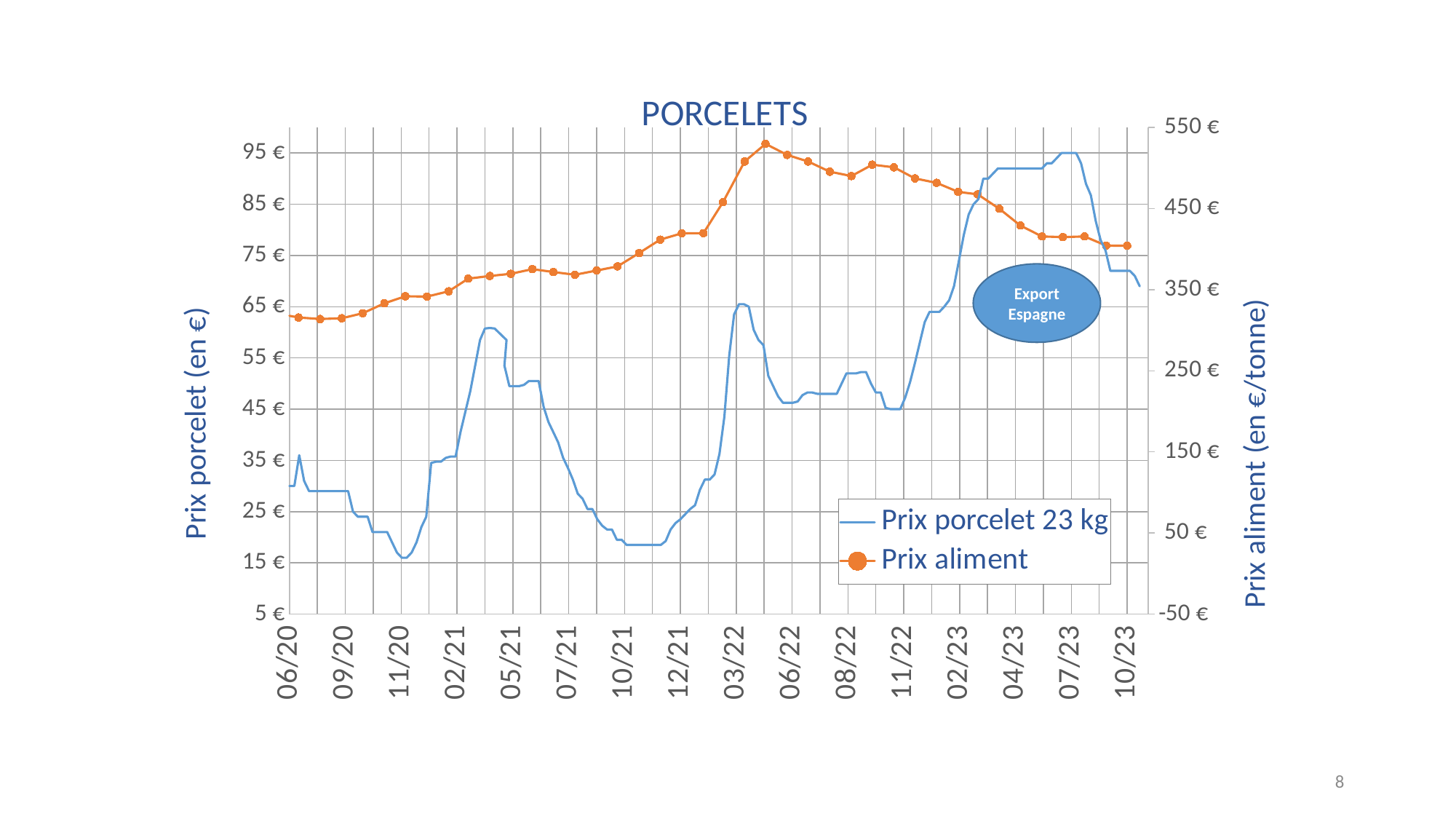
Is the value of Prix porcelet 23 kg at 11/20 greater or less than 25 €? less Is the value of Prix aliment at 06/20 greater or less than 250 €? greater At which labeled month does Prix porcelet 23 kg reach its lowest value? 11/20 What kind of chart is shown on the slide? line chart Is the value of Prix porcelet 23 kg at 07/23 greater or less than 85 €? greater Does Prix aliment rise or fall between 06/20 and 03/22? rise What is the title of the right-hand vertical axis? Prix aliment (en €/tonne) At which labeled month does Prix porcelet 23 kg reach its highest value? 07/23 How many series does the legend list? 2 What is the title of the chart? PORCELETS